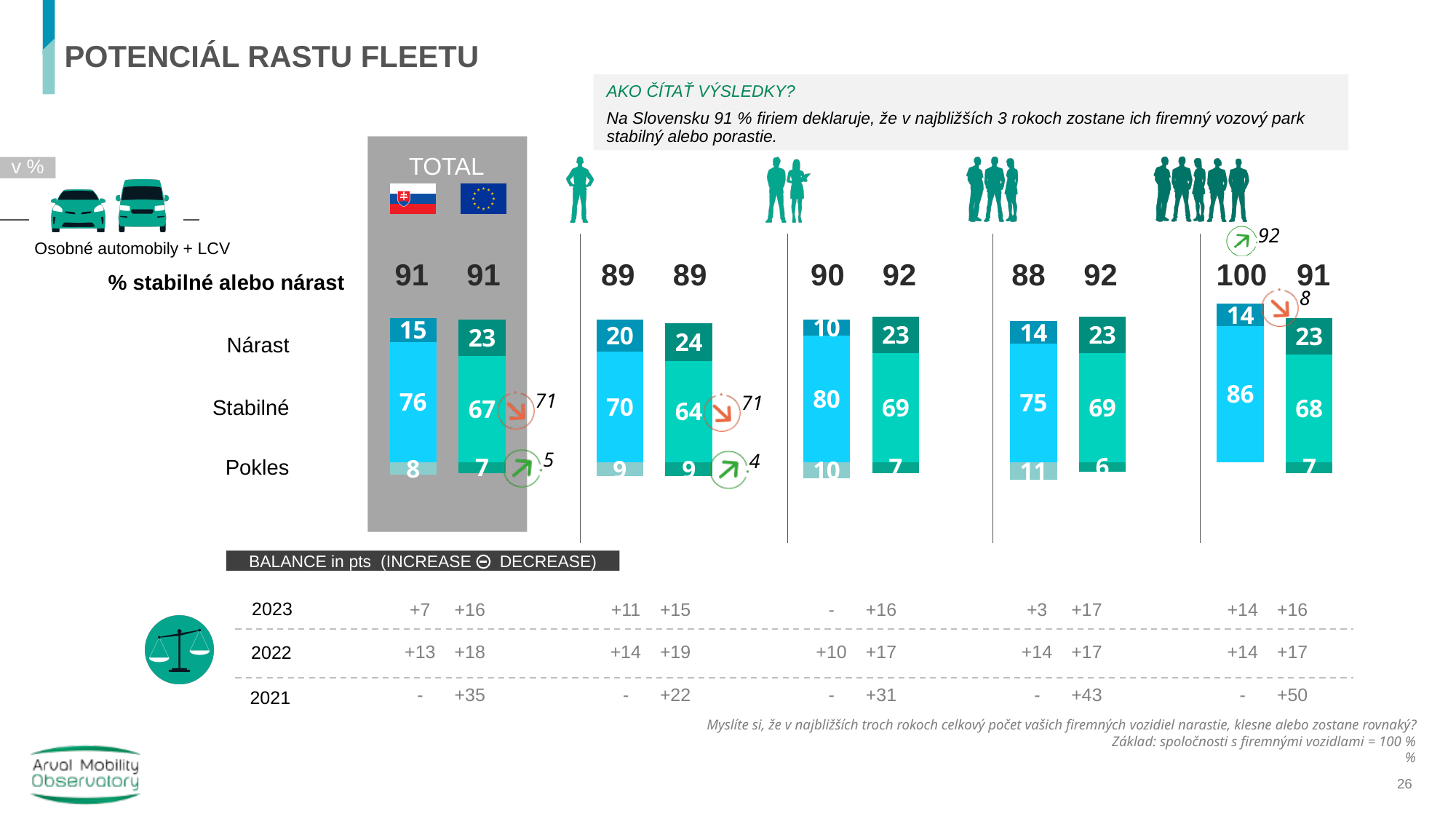
In the TOTAL chart, what is the Pokles value for Slovakia? 8 In the TOTAL chart, what is the difference between the Stabilné values for Slovakia and the EU? 9 What is the highest '% stabilné alebo nárast' value shown for Slovakia across all groups on the slide? 100 In the BALANCE table, which year has the highest EU balance in the TOTAL column? 2021 In the TOTAL chart, what is the Nárast value for Slovakia? 15 In the BALANCE table, what is the 2021 balance for the EU in the TOTAL column? +35 In the TOTAL chart, which has the larger Nárast value, Slovakia or the EU? EU In the TOTAL chart, what is the Stabilné value for the EU bar? 67 In the TOTAL chart, what is the '% stabilné alebo nárast' value for Slovakia? 91 How many segments (categories) does each stacked bar contain? 3 What kind of chart is used to show the Nárast, Stabilné and Pokles values? Stacked bar chart In the BALANCE table, what is the 2023 balance for Slovakia in the TOTAL column? +7